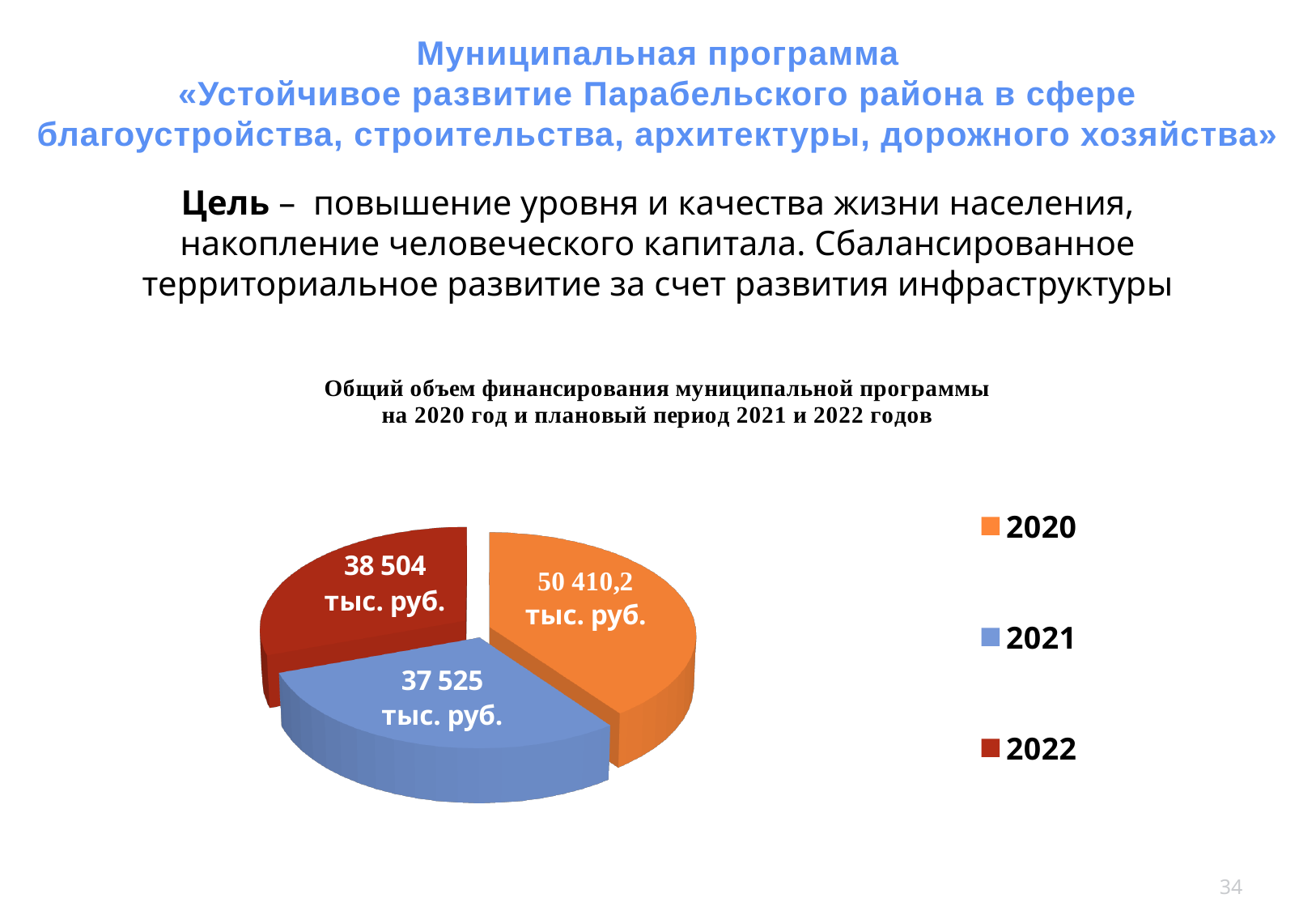
What is the difference between the 2020 and 2021 values on the pie chart? 12 885,2 тыс. руб. Which year has the smallest slice of the pie chart? 2021 What is the funding value shown for 2022 on the pie chart? 38 504 тыс. руб. Which year has the largest slice of the pie chart? 2020 What type of chart is shown on the slide? Pie chart Which is larger on the pie chart, the value for 2021 or the value for 2022? 2022 What is the funding value shown for 2021 on the pie chart? 37 525 тыс. руб. What colour is the slice for 2022 on the pie chart? Red How many entries does the legend of the pie chart list? 3 What is the funding value shown for 2020 on the pie chart? 50 410,2 тыс. руб. How many slices does the pie chart have? 3 What is the difference between the 2022 and 2021 values on the pie chart? 979 тыс. руб.